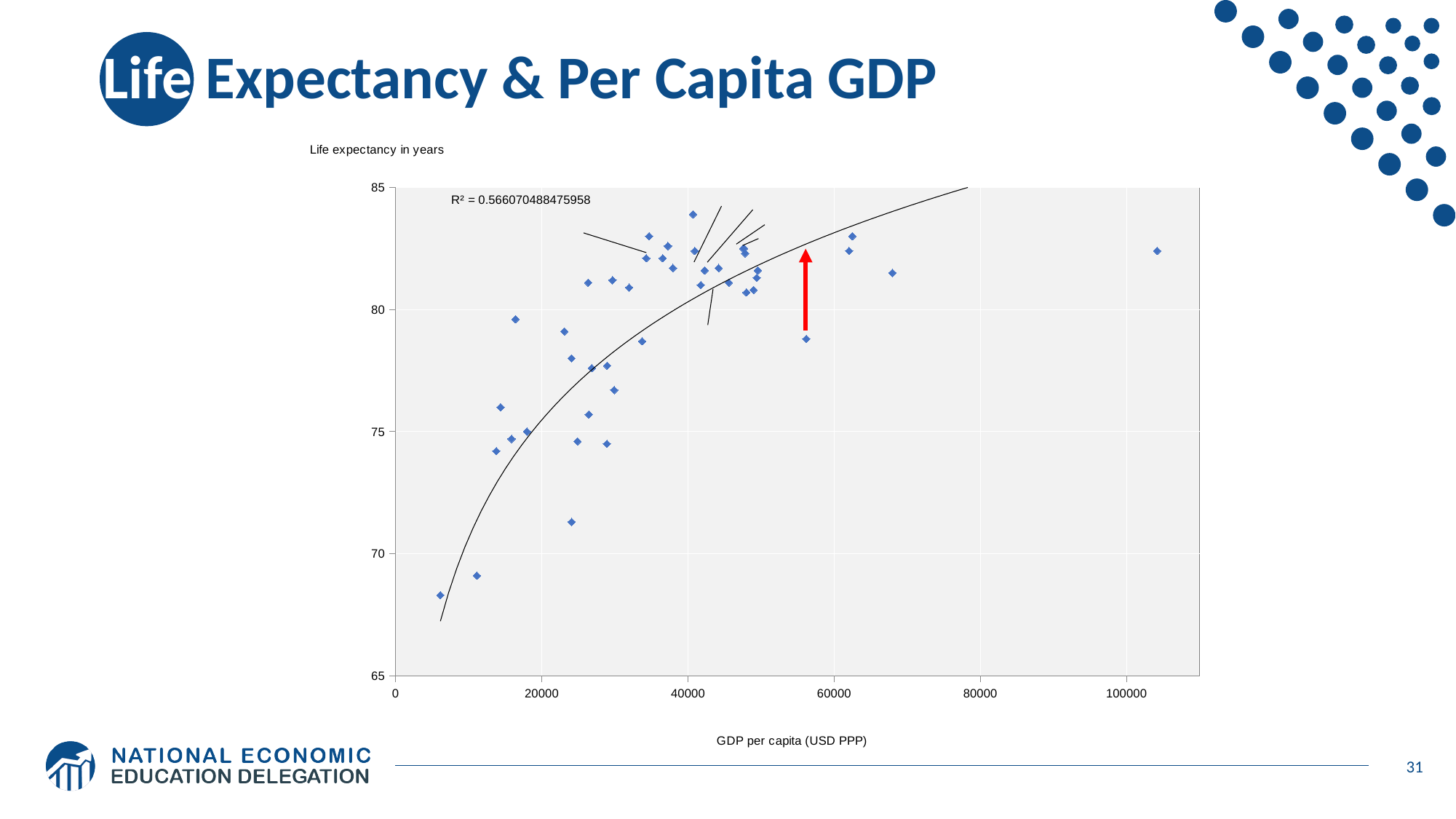
Is the GDP per capita of the leftmost point greater or less than 20000? less What R² value is printed on the chart? R² = 0.566070488475958 Is the highest life expectancy plotted on the chart greater or less than 85? less As GDP per capita increases along the x axis, does life expectancy generally rise or fall? Rise What kind of chart is shown on the slide? Scatter plot Is the GDP per capita of the rightmost point greater or less than 100000? greater What is the label of the horizontal axis of the chart? GDP per capita (USD PPP) What is the label of the vertical axis of the chart? Life expectancy in years